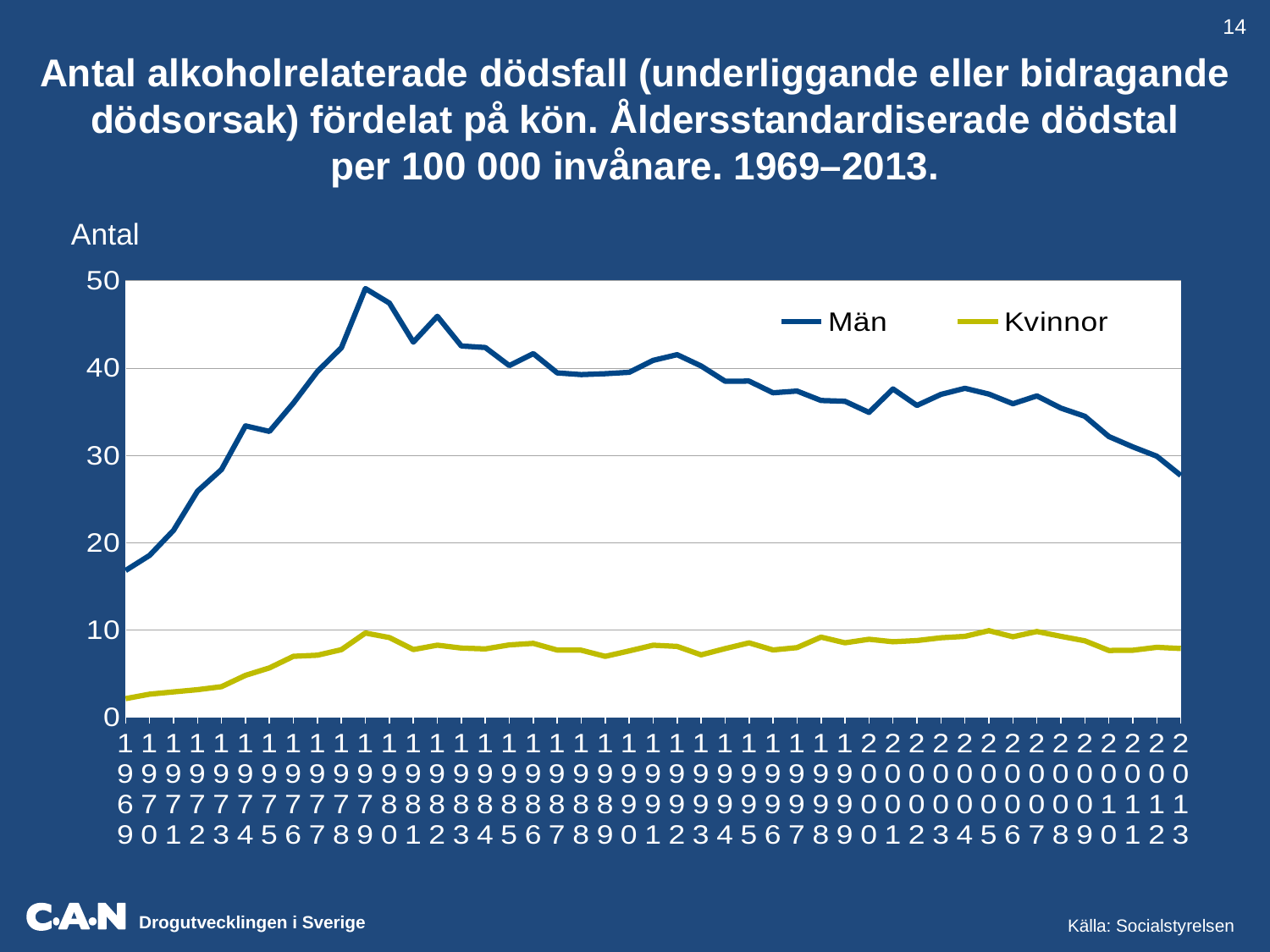
What kind of chart is shown on the slide? line chart Is the value for Män in 1969 greater or less than 20? less What are the two series named in the legend? Män and Kvinnor Does the Män series rise or fall between 1969 and 1979? rise How many years are plotted along the x axis? 45 Is the value for Kvinnor in 2013 greater or less than 10? less In which year is the Män series at its lowest value? 1969 Is the value for Män in 1979 greater or less than 40? greater In which year does the Män series reach its highest value? 1979 How many series does the legend list? 2 In which year is the Kvinnor series at its lowest value? 1969 Which series has the larger value in 1990, Män or Kvinnor? Män